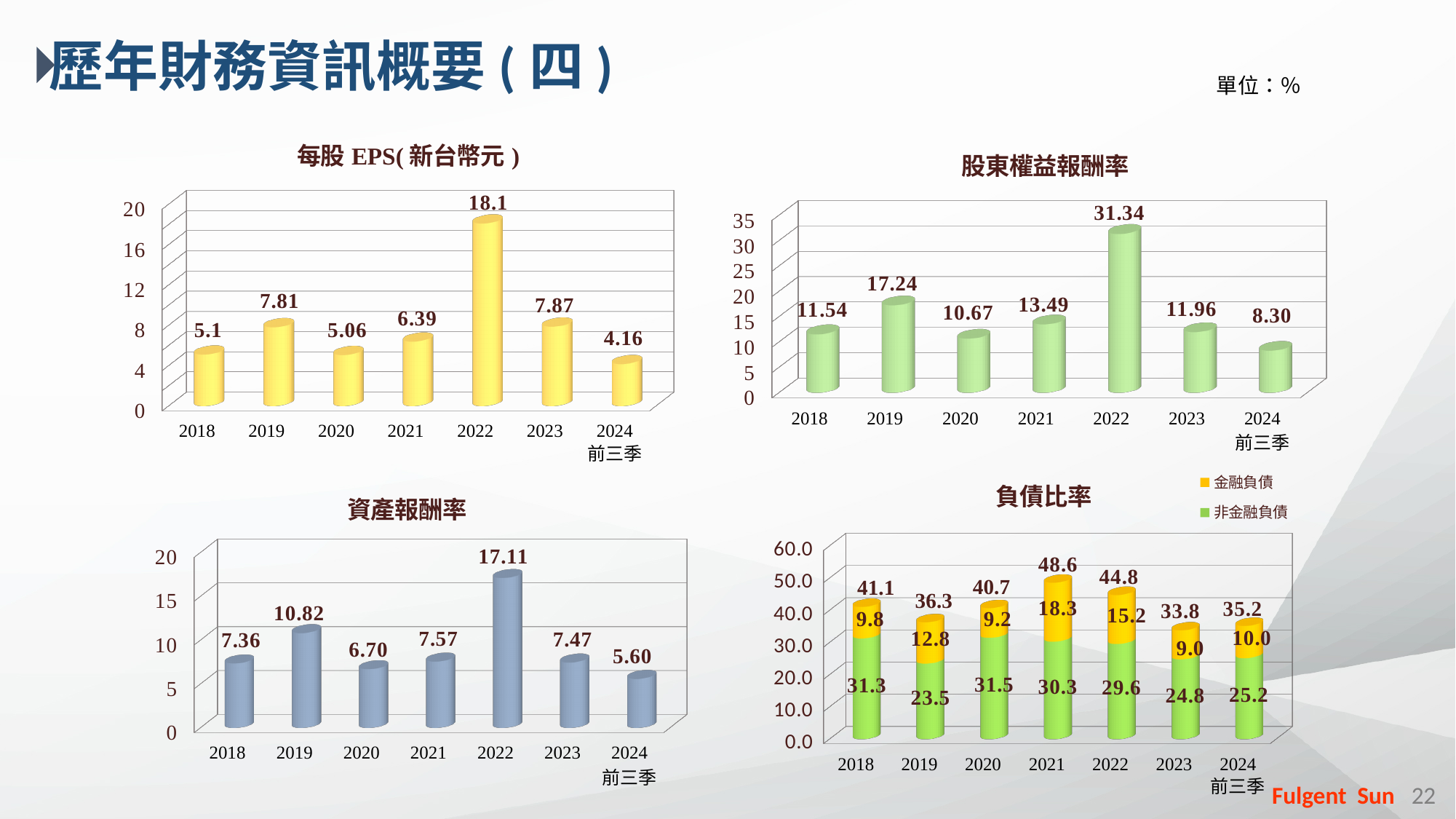
In the 負債比率 chart, what is the 金融負債 value for 2021? 18.3 In the 資產報酬率 chart, how many years are shown on the x axis? 7 In the 負債比率 chart, how many series does the legend list? 2 In the 股東權益報酬率 chart, what is the difference between the 2022 value and the 2023 value? 19.38 In the 每股 EPS( 新台幣元 ) chart, what is the value for 2022? 18.1 In the 資產報酬率 chart, what is the value for 2020? 6.70 In the 每股 EPS( 新台幣元 ) chart, which year has the lowest value? 2024 前三季 In the 股東權益報酬率 chart, what is the value for 2019? 17.24 In the 股東權益報酬率 chart, which year has the highest value? 2022 In the 資產報酬率 chart, which is larger, the value for 2019 or the value for 2021? 2019 In the 負債比率 chart, what is the total of the stacked bar for 2018? 41.1 What kind of chart is the 資產報酬率 chart? Bar chart